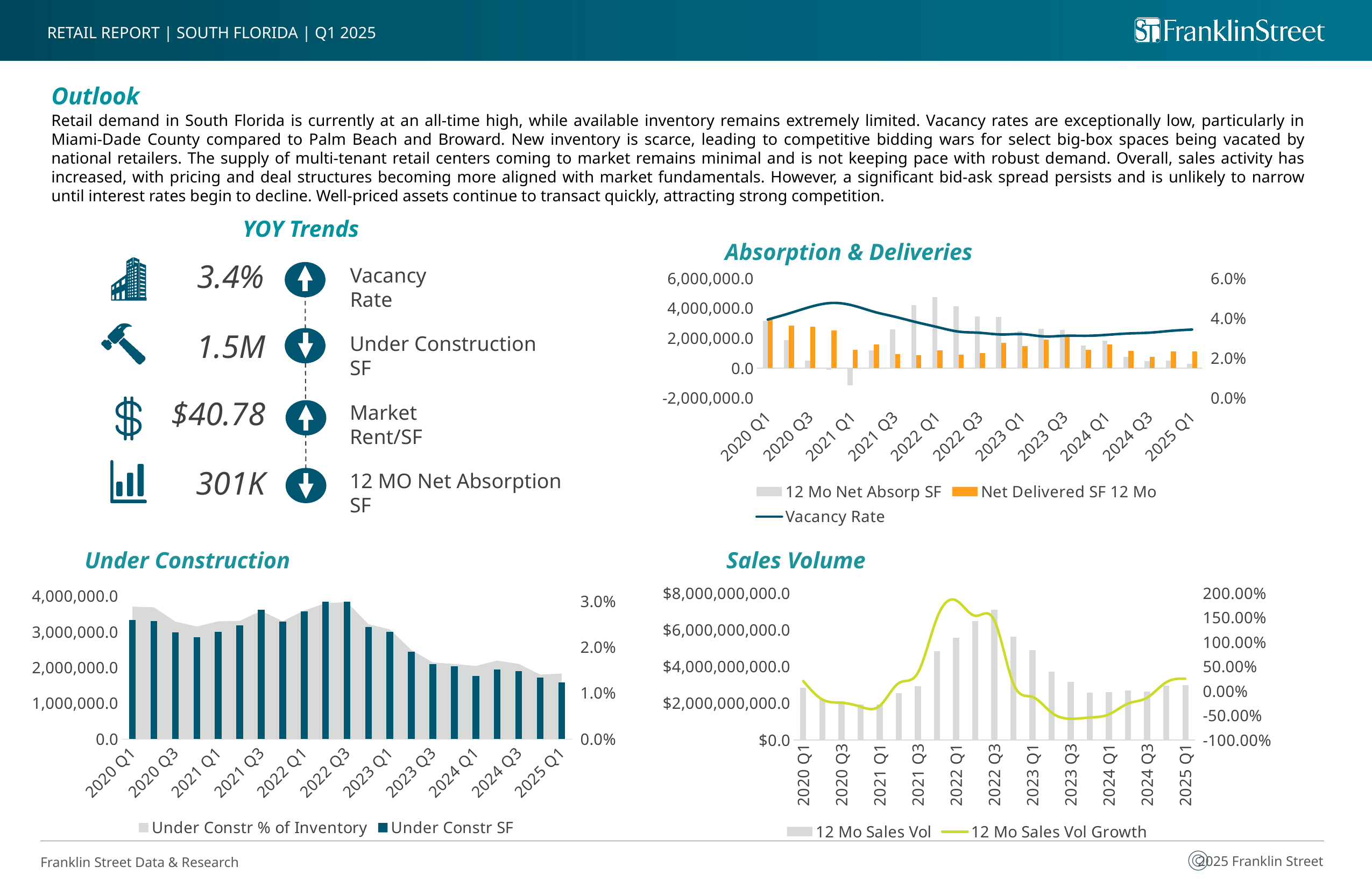
In the Under Construction chart, is the Under Constr SF value for 2020 Q1 greater or less than 3,000,000.0? greater In the Absorption & Deliveries chart, is the 12 Mo Net Absorp SF value for 2022 Q1 greater or less than 4,000,000.0? greater In the Sales Volume chart, is the 12 Mo Sales Vol for 2022 Q3 greater or less than $6,000,000,000.0? greater In the Under Construction chart, does the Under Constr SF series rise or fall from 2022 Q3 to 2025 Q1? fall In the Sales Volume chart, which quarter has the highest 12 Mo Sales Vol bar? 2022 Q3 In the Absorption & Deliveries chart, what colour are the Net Delivered SF 12 Mo bars? Orange How many series does the legend of the Absorption & Deliveries chart list? 3 How many series does the legend of the Sales Volume chart list? 2 What kind of chart is the Under Construction chart? Combination bar and area chart In the Absorption & Deliveries chart, which quarter has the highest 12 Mo Net Absorp SF bar? 2022 Q1